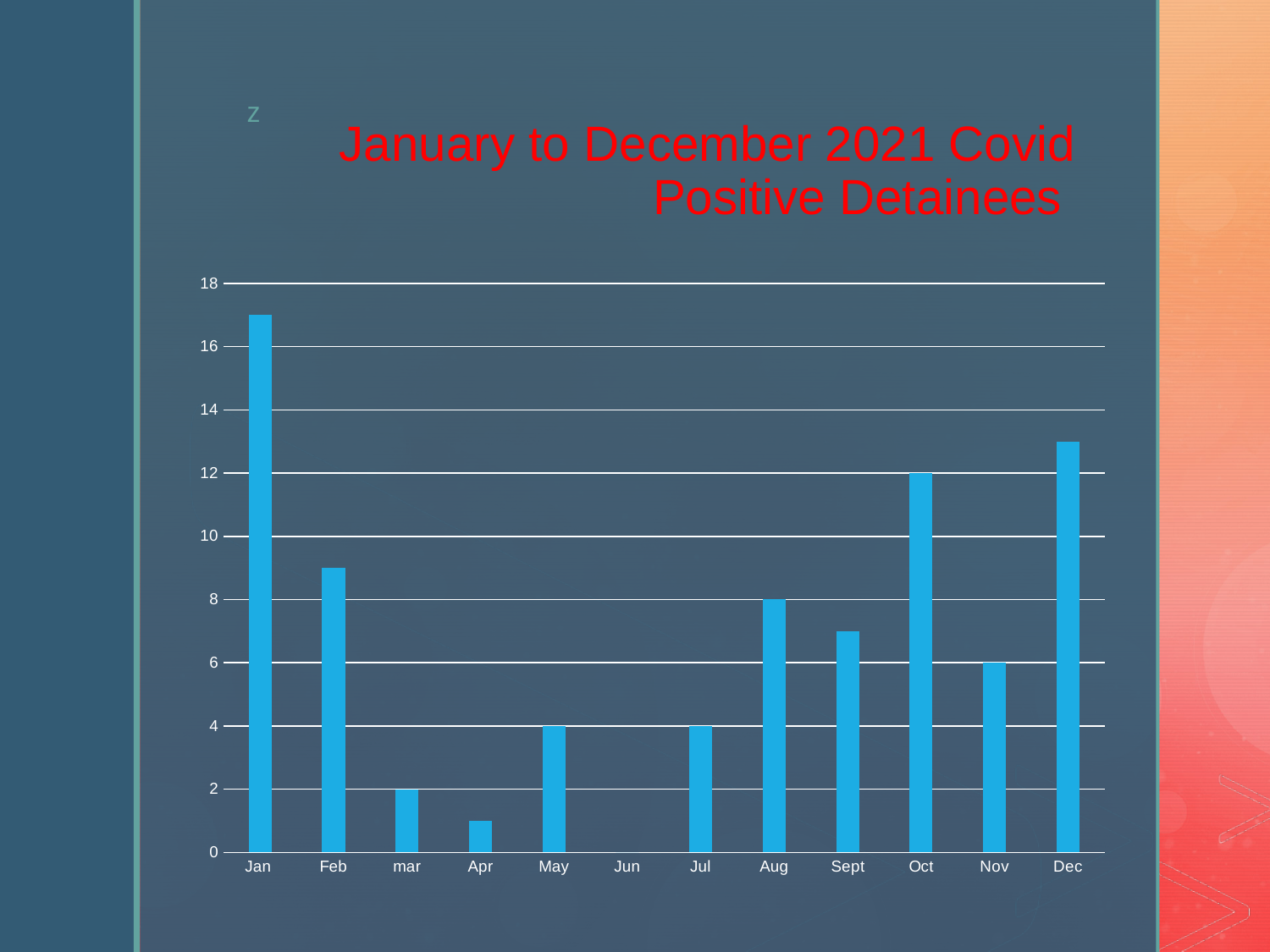
Is the value for Jan greater or less than 16? greater Which is larger, the value for Jan or the value for Dec? Jan What kind of chart is shown on the slide? bar chart What is the title of the chart? January to December 2021 Covid Positive Detainees How many months are shown on the x axis? 12 What is the difference between the values for Oct and Aug? 4 Is the value for Feb greater or less than 10? less What is the value for Aug? 8 Which month has the highest value? Jan What is the value for mar? 2 What is the value for Oct? 12 What is the value for Nov? 6